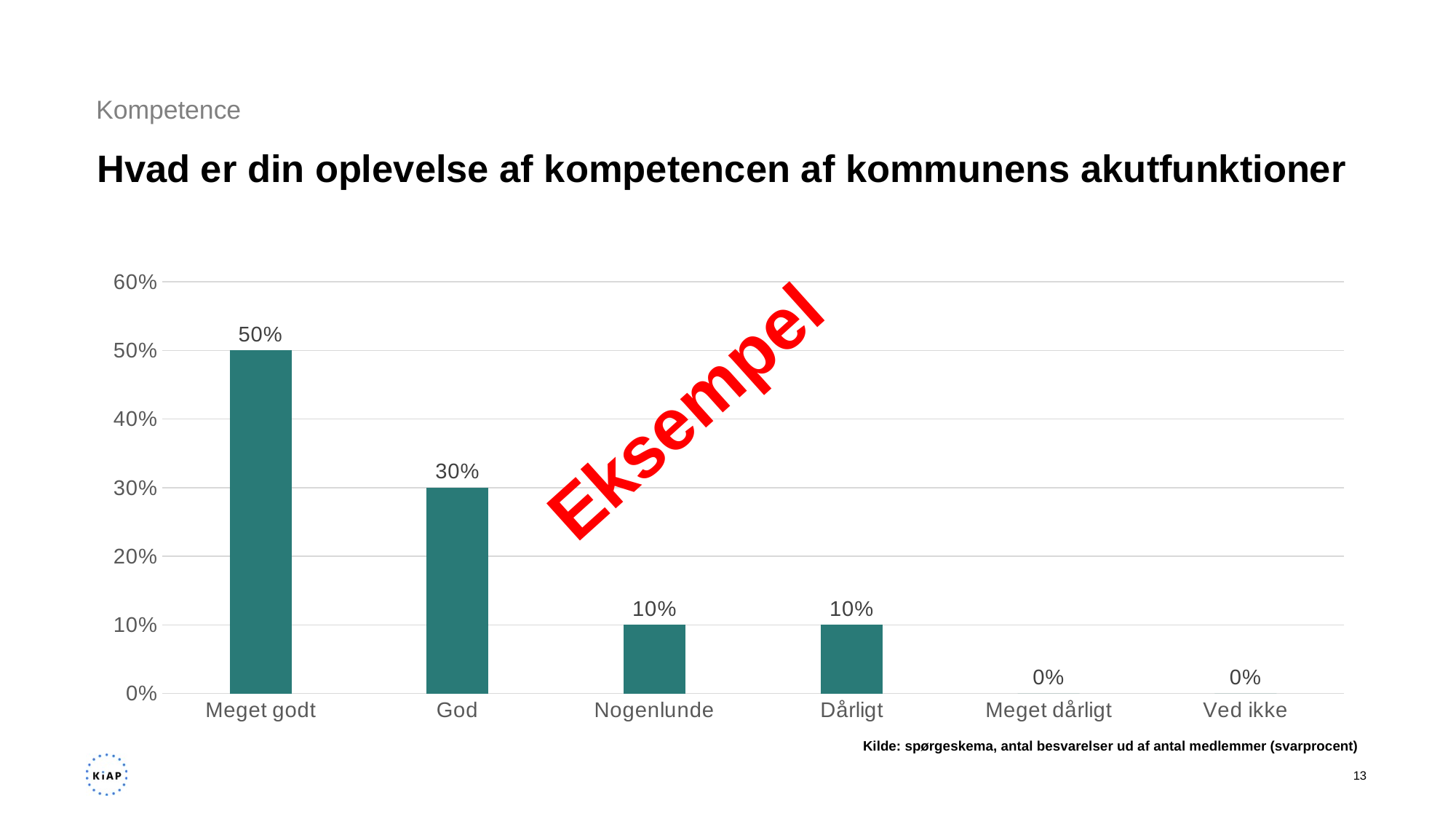
What is the value for Nogenlunde? 10% Which is larger, the value for God or the value for Dårligt? God What kind of chart is shown on the slide? Bar chart Which category has the highest value? Meget godt What is the difference between the values for Meget godt and God? 20% How many categories are shown on the x axis? 6 What is the highest value shown on the y axis? 60% What is the value for Meget dårligt? 0% What is the value for Meget godt? 50% What is the value for God? 30% Do the values rise or fall from Meget godt to Dårligt along the x axis? Fall What is the title of the chart? Hvad er din oplevelse af kompetencen af kommunens akutfunktioner